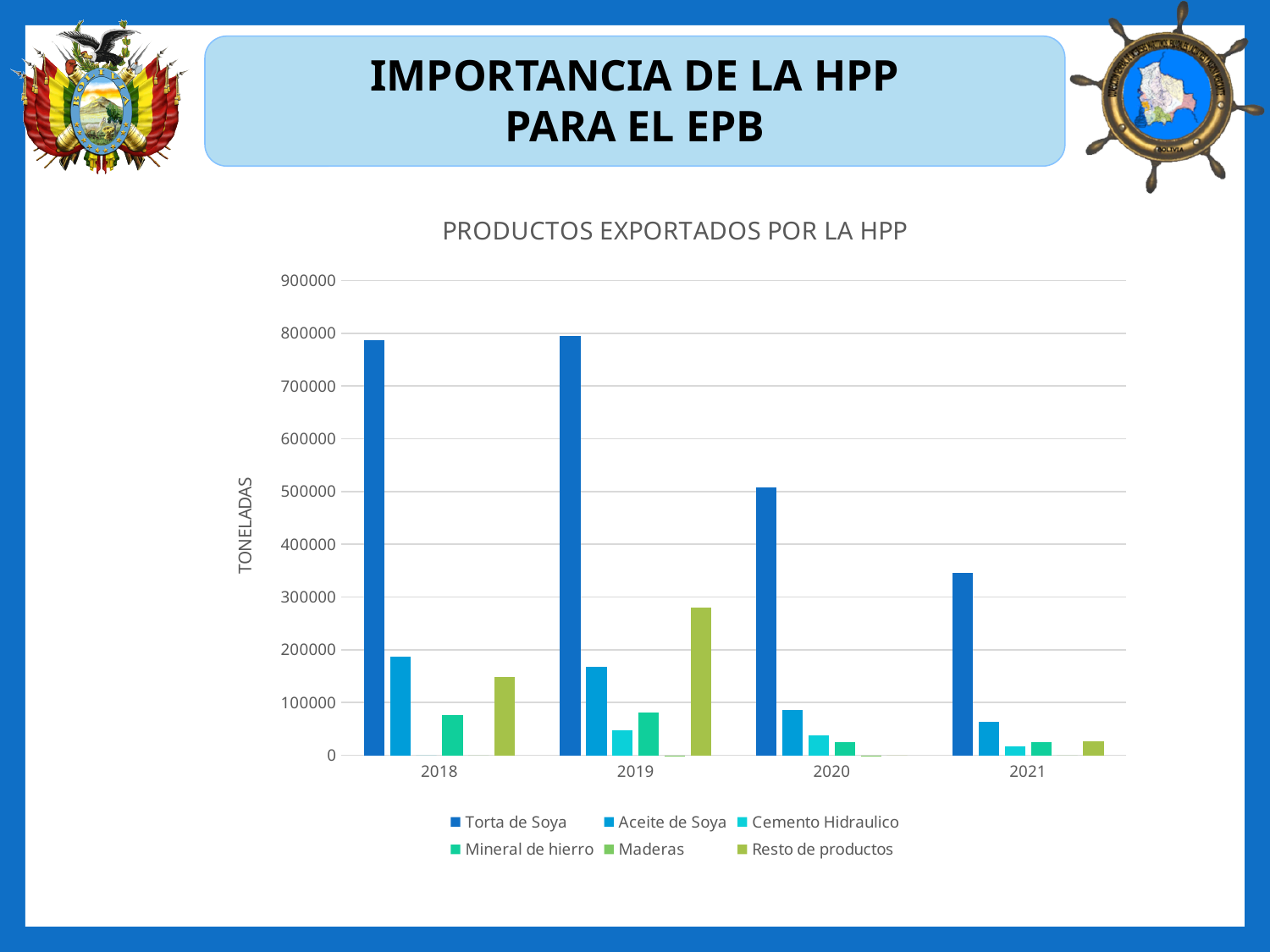
How many series does the legend list? 6 Which series has the highest value in 2020? Torta de Soya What type of chart is shown on the slide? Bar chart What is the label on the vertical axis of the chart? TONELADAS How many years are shown on the x axis of the chart? 4 In which year is the value for Torta de Soya the lowest? 2021 Is the value for Torta de Soya in 2018 greater or less than 700000? greater Is the value for Aceite de Soya in 2021 greater or less than 100000? less Is the value for Torta de Soya in 2020 greater or less than 600000? less What is the title of the chart? PRODUCTOS EXPORTADOS POR LA HPP Which is larger, Resto de productos in 2019 or Resto de productos in 2018? Resto de productos in 2019